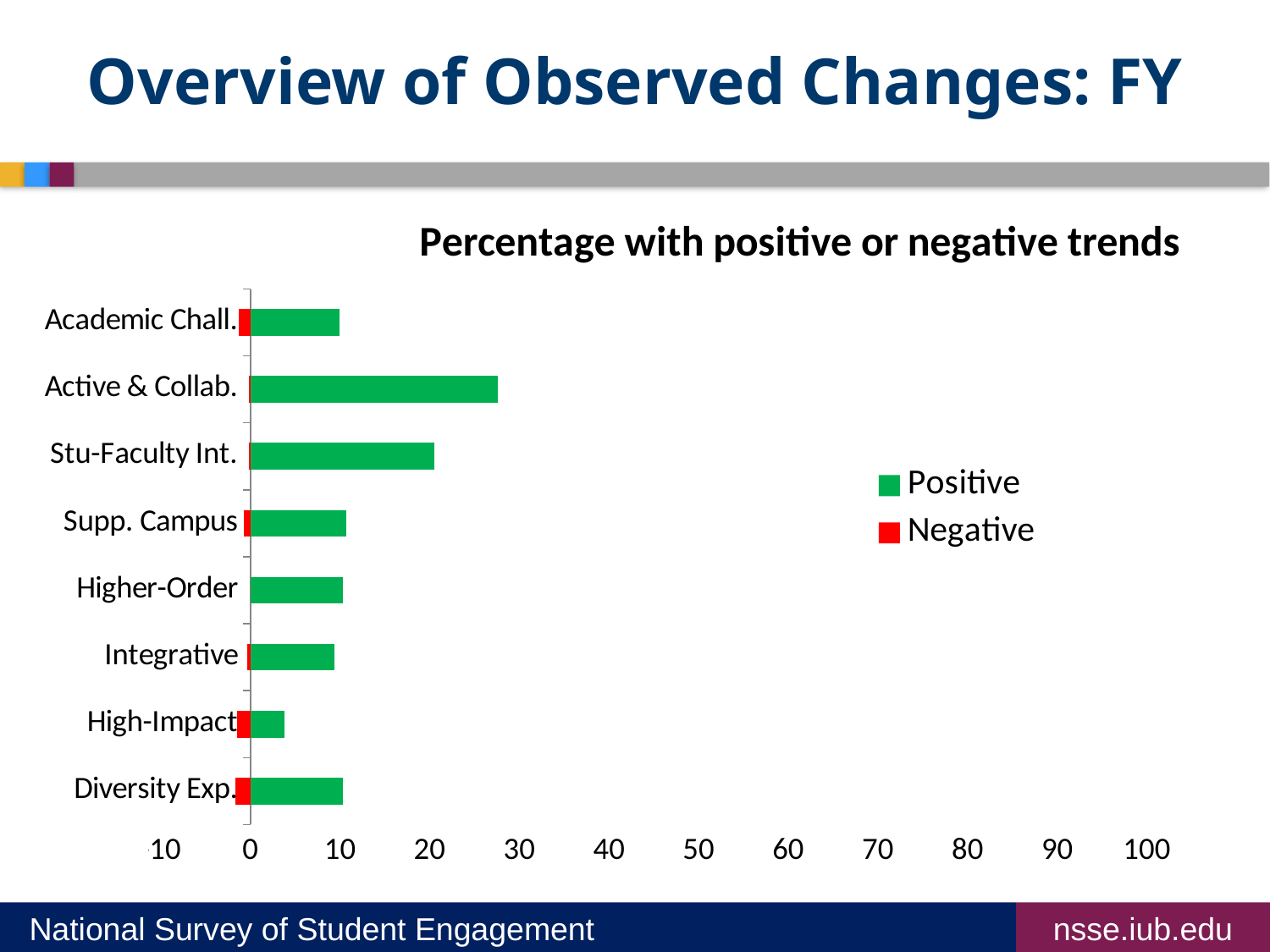
What is the title of the chart? Percentage with positive or negative trends Which has the larger Positive value, Higher-Order or High-Impact? Higher-Order Is the Positive value for High-Impact greater or less than 10? less Which category has the highest Positive value? Active & Collab. What kind of chart is shown on the slide? bar chart Is the Positive value for Stu-Faculty Int. greater or less than 30? less How many series does the legend list? 2 Which has the larger Positive value, Active & Collab. or Stu-Faculty Int.? Active & Collab. What colour represents the Negative series in the legend? red Which category has the lowest Positive value? High-Impact Is the Positive value for Active & Collab. greater or less than 20? greater How many categories are shown on the chart? 8